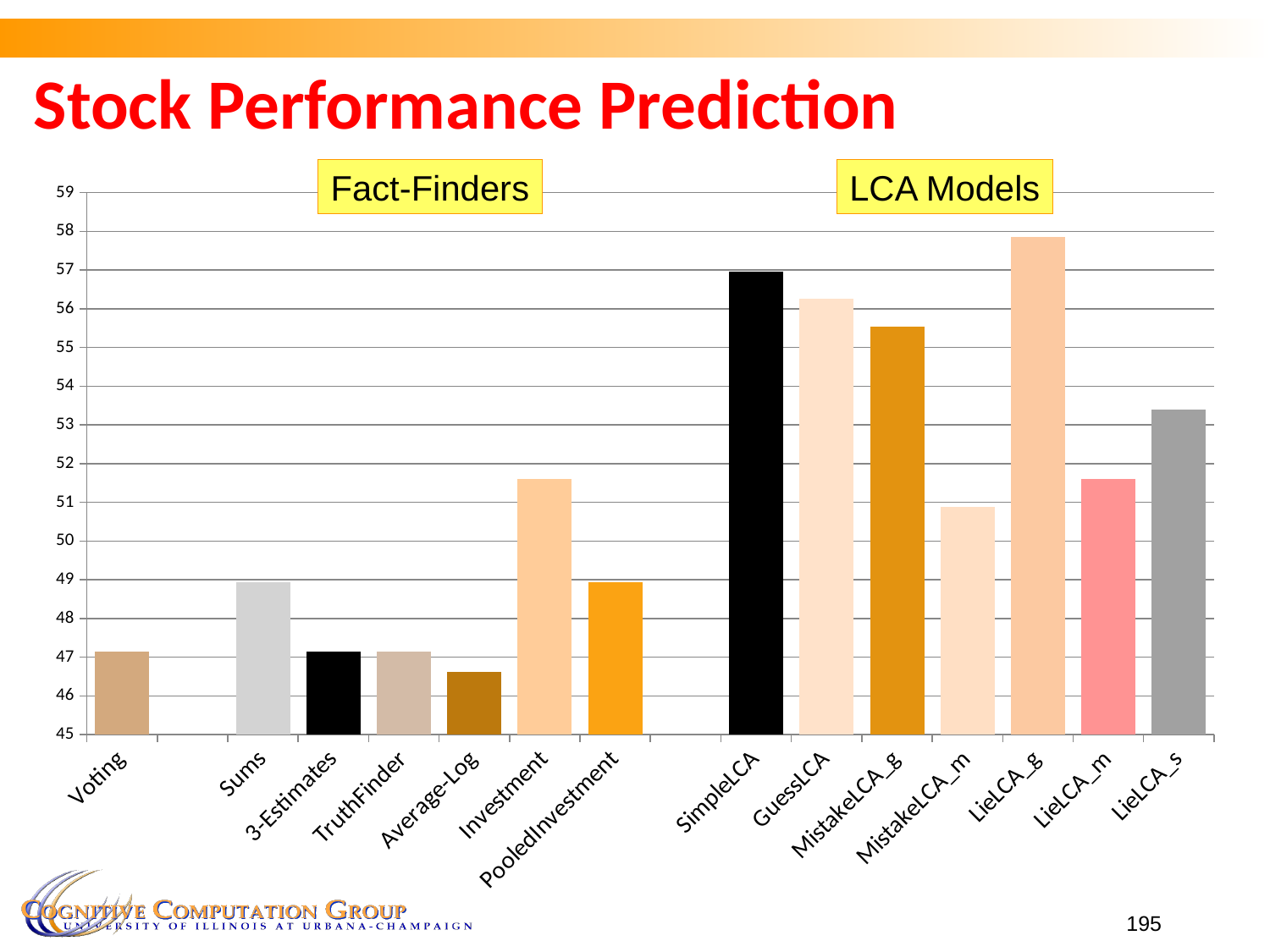
Is the value for SimpleLCA greater or less than 56? greater How many labeled categories are shown on the x axis of the chart? 14 Which category has the highest bar in the chart? LieLCA_g What is the title of the slide containing the chart? Stock Performance Prediction Which category has the lowest bar in the chart? Average-Log What are the two group labels shown above the chart? Fact-Finders and LCA Models Which is larger, the value for GuessLCA or the value for MistakeLCA_g? GuessLCA Is the value for Investment greater or less than 52? less Which is larger, the value for Sums or the value for Voting? Sums Is the value for LieLCA_s greater or less than 53? greater What kind of chart is shown on the slide? bar chart